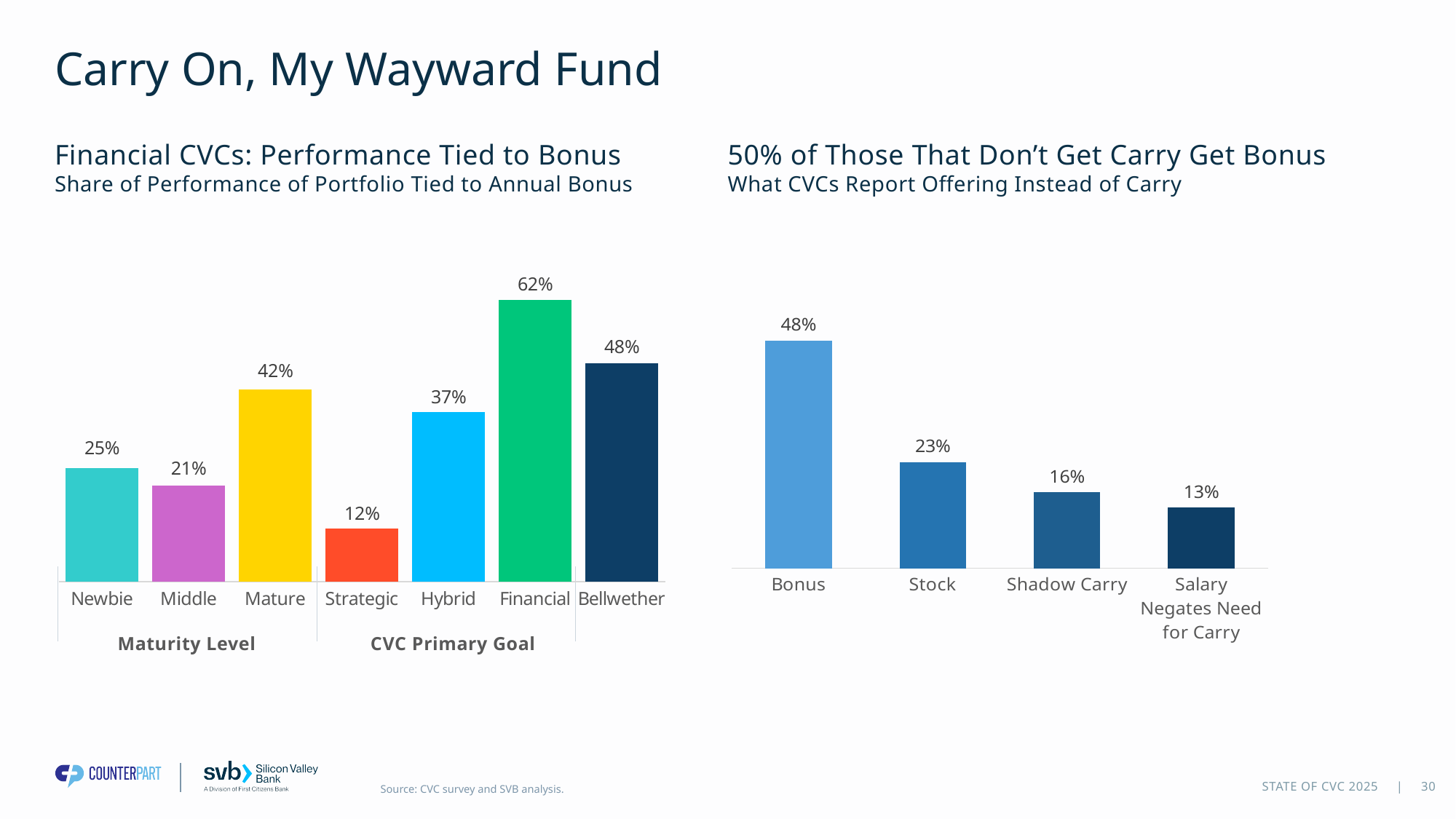
In the '50% of Those That Don't Get Carry Get Bonus' chart, what is the difference between Bonus and Shadow Carry? 32% In the 'Financial CVCs: Performance Tied to Bonus' chart, what is the value for Strategic? 12% In the 'Financial CVCs: Performance Tied to Bonus' chart, what is the difference between Financial and Bellwether? 14% What kind of chart is the '50% of Those That Don't Get Carry Get Bonus' chart? bar chart How many bars are in the 'Financial CVCs: Performance Tied to Bonus' chart? 7 In the 'Financial CVCs: Performance Tied to Bonus' chart, what is the value for Mature? 42% In the 'Financial CVCs: Performance Tied to Bonus' chart, which category has the highest value? Financial In the 'Financial CVCs: Performance Tied to Bonus' chart, which category has the lowest value? Strategic In the 'Financial CVCs: Performance Tied to Bonus' chart, which is larger, Newbie or Middle? Newbie In the '50% of Those That Don't Get Carry Get Bonus' chart, which category has the highest value? Bonus In the '50% of Those That Don't Get Carry Get Bonus' chart, do the values rise or fall from left to right? fall In the '50% of Those That Don't Get Carry Get Bonus' chart, what is the value for Stock? 23%